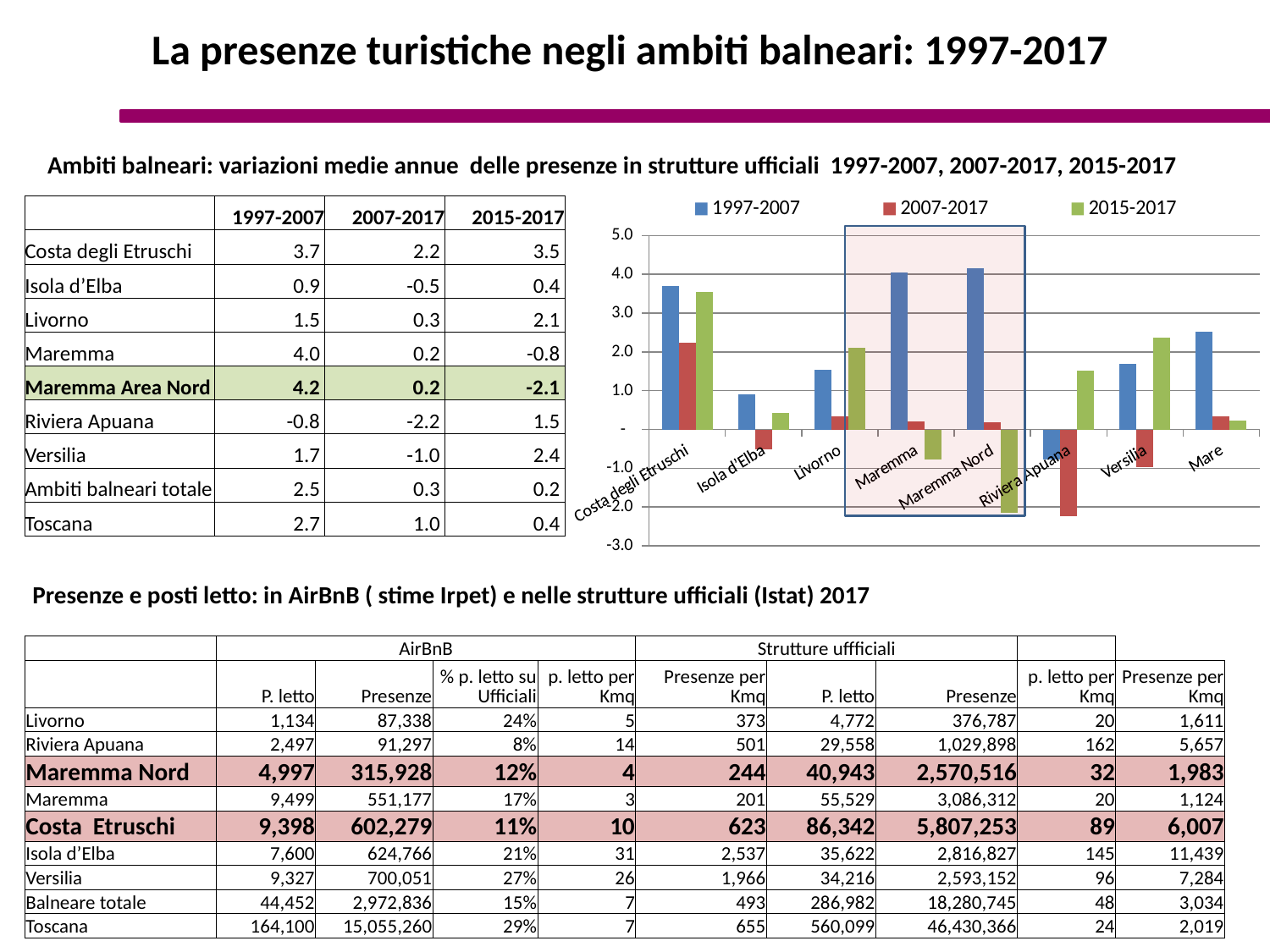
How many series does the chart's legend list? 3 What kind of chart is shown on the slide? bar chart In the chart, which category has the lowest value for the 2015-2017 series? Maremma Nord In the chart, which category has the lowest value for the 1997-2007 series? Riviera Apuana In the chart, which category has the highest value for the 2015-2017 series? Costa degli Etruschi Which series in the chart is drawn in green? 2015-2017 In the chart, for Livorno, which is larger: the 1997-2007 value or the 2015-2017 value? 2015-2017 In the chart, is the 2007-2017 value for Riviera Apuana greater or less than -1.0? less How many categories are shown along the x axis of the chart? 8 Which series in the chart is drawn in blue? 1997-2007 In the chart, for Versilia, which is larger: the 1997-2007 value or the 2015-2017 value? 2015-2017 In the chart, is the 1997-2007 value for Maremma greater or less than 3.0? greater